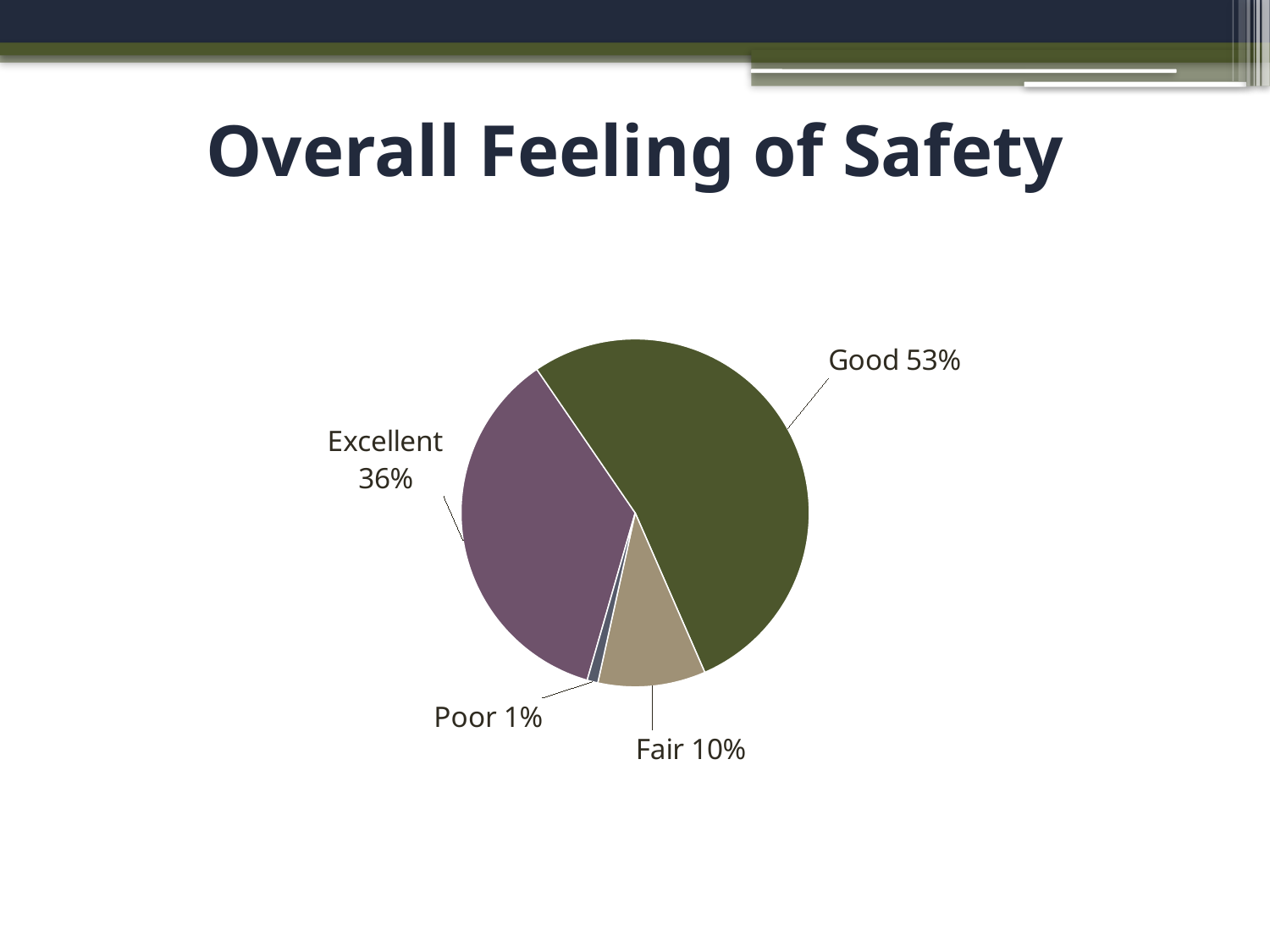
What is the title of the slide containing the pie chart? Overall Feeling of Safety What percentage of respondents rated their overall feeling of safety as Good? 53% What percentage of respondents rated their overall feeling of safety as Fair? 10% Which is larger, the Fair slice or the Poor slice? Fair What is the difference in percentage points between the Good and Excellent slices? 17 What percentage of respondents rated their overall feeling of safety as Poor? 1% What is the combined share of the Good and Excellent slices? 89% What percentage of respondents rated their overall feeling of safety as Excellent? 36% Which category has the largest share of the pie? Good Which category has the smallest share of the pie? Poor What kind of chart is shown on the slide? pie chart How many categories are shown in the pie chart? 4